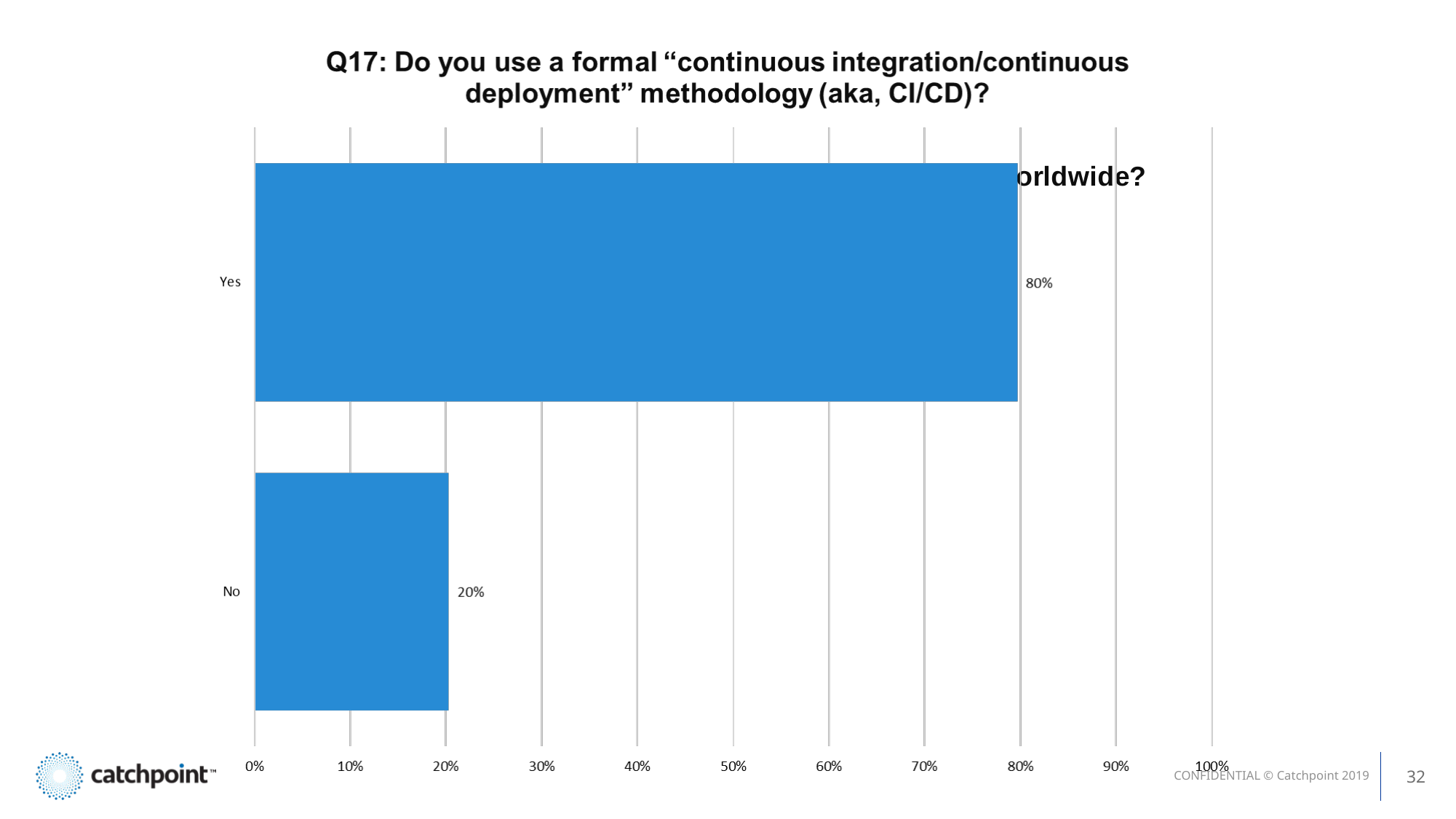
What percentage of respondents answered "No" to using a formal CI/CD methodology? 20% How many response categories are shown in the chart? 2 Is the value for "No" greater or less than 30%? less Which response category has the lowest value? No Which response category has the highest value? Yes Is the value for "Yes" greater or less than 50%? greater What is the maximum value shown on the horizontal axis? 100% What question number is referenced in the chart title? Q17 What percentage of respondents answered "Yes" to using a formal CI/CD methodology? 80% What is the difference between the "Yes" and "No" percentages? 60% Which is larger, the value for "Yes" or the value for "No"? Yes What kind of chart is shown on the slide? Bar chart